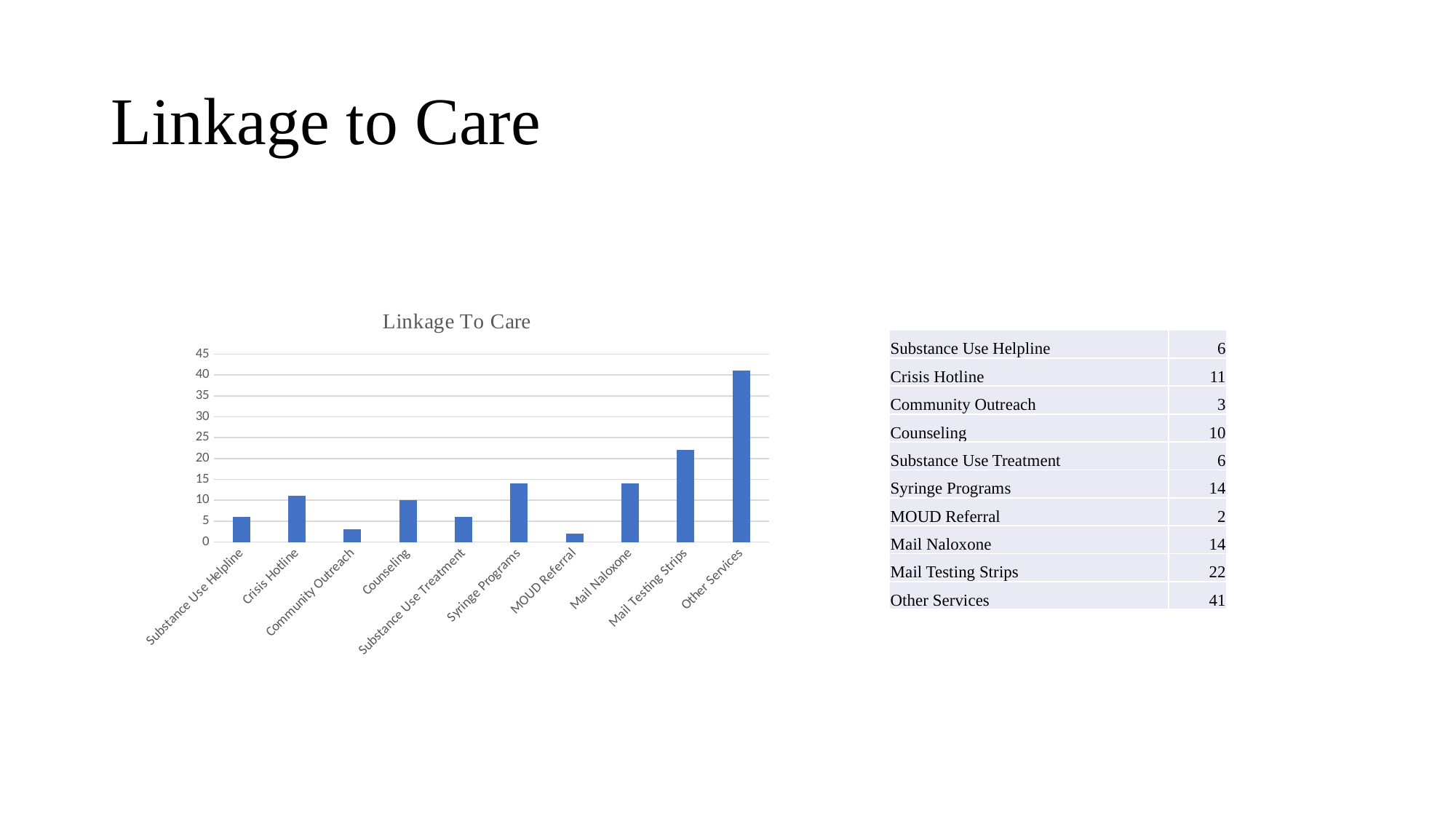
What kind of chart is the Linkage To Care chart? Bar chart What is the value for Counseling in the Linkage To Care chart? 10 Is the value for Mail Testing Strips greater or less than 20 in the Linkage To Care chart? greater Which is larger in the Linkage To Care chart, Syringe Programs or Crisis Hotline? Syringe Programs What is the title of the chart on the slide? Linkage To Care What is the difference between the values for Other Services and Mail Testing Strips in the Linkage To Care chart? 19 What is the value for Other Services in the Linkage To Care chart? 41 Which category has the lowest value in the Linkage To Care chart? MOUD Referral What is the difference between the values for Crisis Hotline and Community Outreach in the Linkage To Care chart? 8 What is the value for Mail Testing Strips in the Linkage To Care chart? 22 Which category has the highest value in the Linkage To Care chart? Other Services How many categories are shown in the Linkage To Care chart? 10